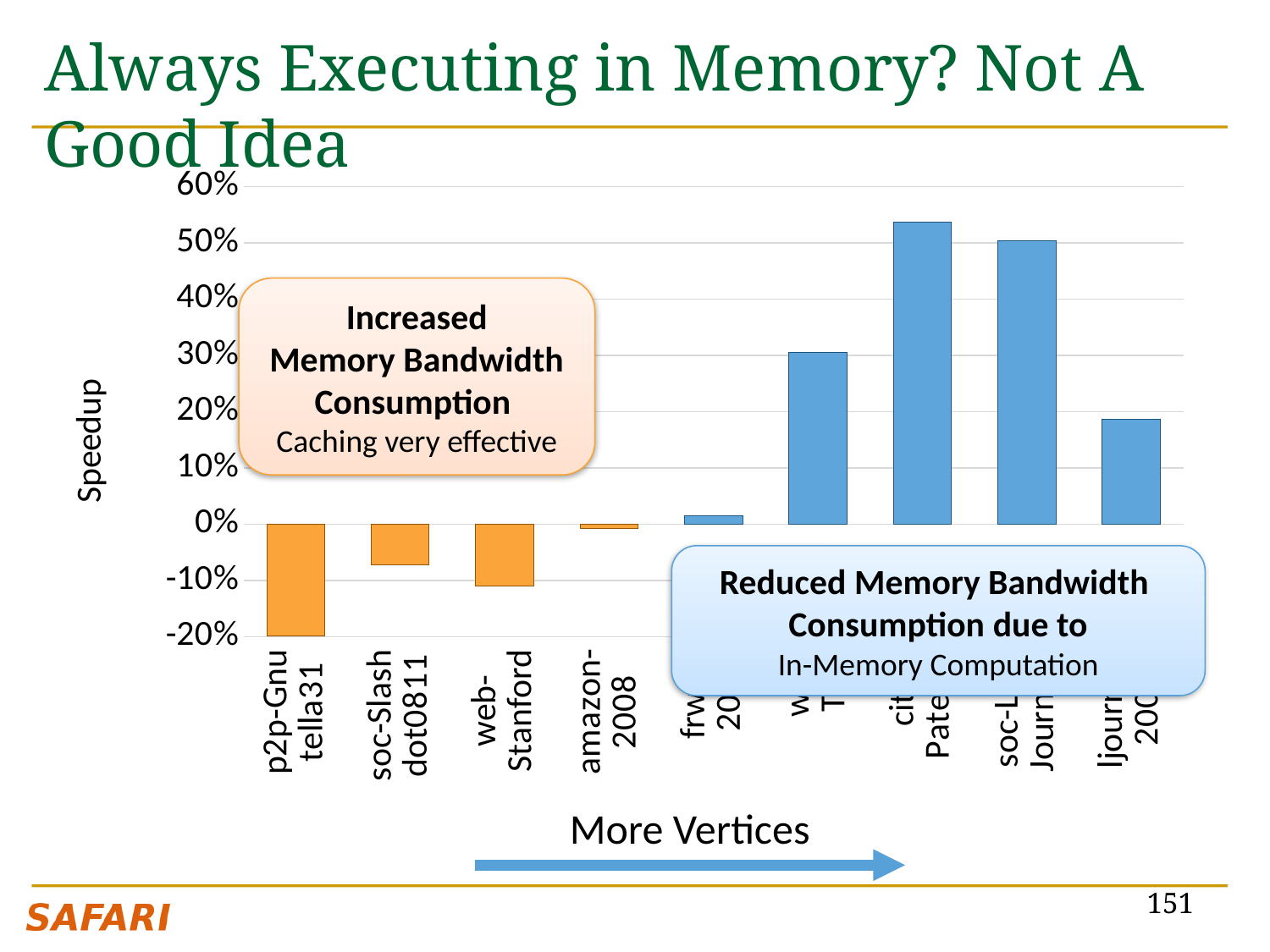
What is the label of the vertical axis of the chart? Speedup Is the speedup for amazon-2008 greater or less than -10%? greater Is the speedup for soc-Slashdot0811 greater or less than -10%? greater Which has the larger speedup, p2p-Gnutella31 or amazon-2008? amazon-2008 How many bars in the chart are coloured orange? 4 How many bars are plotted in the chart? 9 Which has the larger speedup, soc-Slashdot0811 or web-Stanford? soc-Slashdot0811 Is the speedup for web-Stanford greater or less than 0%? less Do the speedup values generally rise or fall from left to right along the x axis? rise Which category has the lowest speedup in the chart? p2p-Gnutella31 What kind of chart is shown on the slide? bar chart